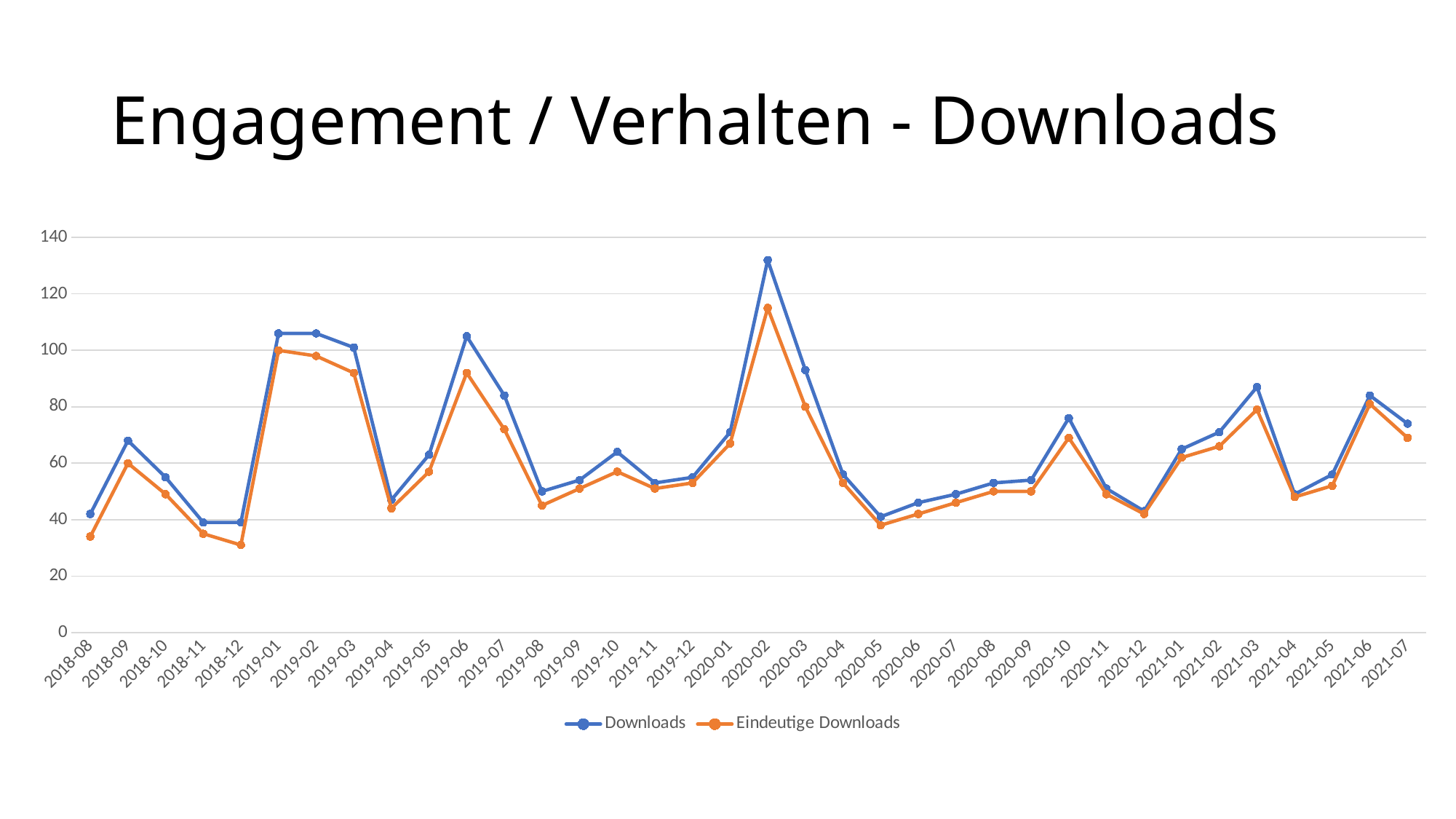
In which month does the Eindeutige Downloads series reach its highest value? 2020-02 Is the value for Eindeutige Downloads in 2018-12 greater or less than 40? less What is the title of the chart slide? Engagement / Verhalten - Downloads In 2020-02, which series has the larger value, Downloads or Eindeutige Downloads? Downloads How many series does the legend list? 2 Is the value for Downloads in 2019-01 greater or less than 100? greater Is the value for Downloads in 2020-05 greater or less than 60? less In which month does the Downloads series reach its highest value? 2020-02 Do the Downloads values rise or fall from 2020-02 to 2020-05? fall How many months are plotted along the x axis? 36 What kind of chart is shown on the slide? line chart